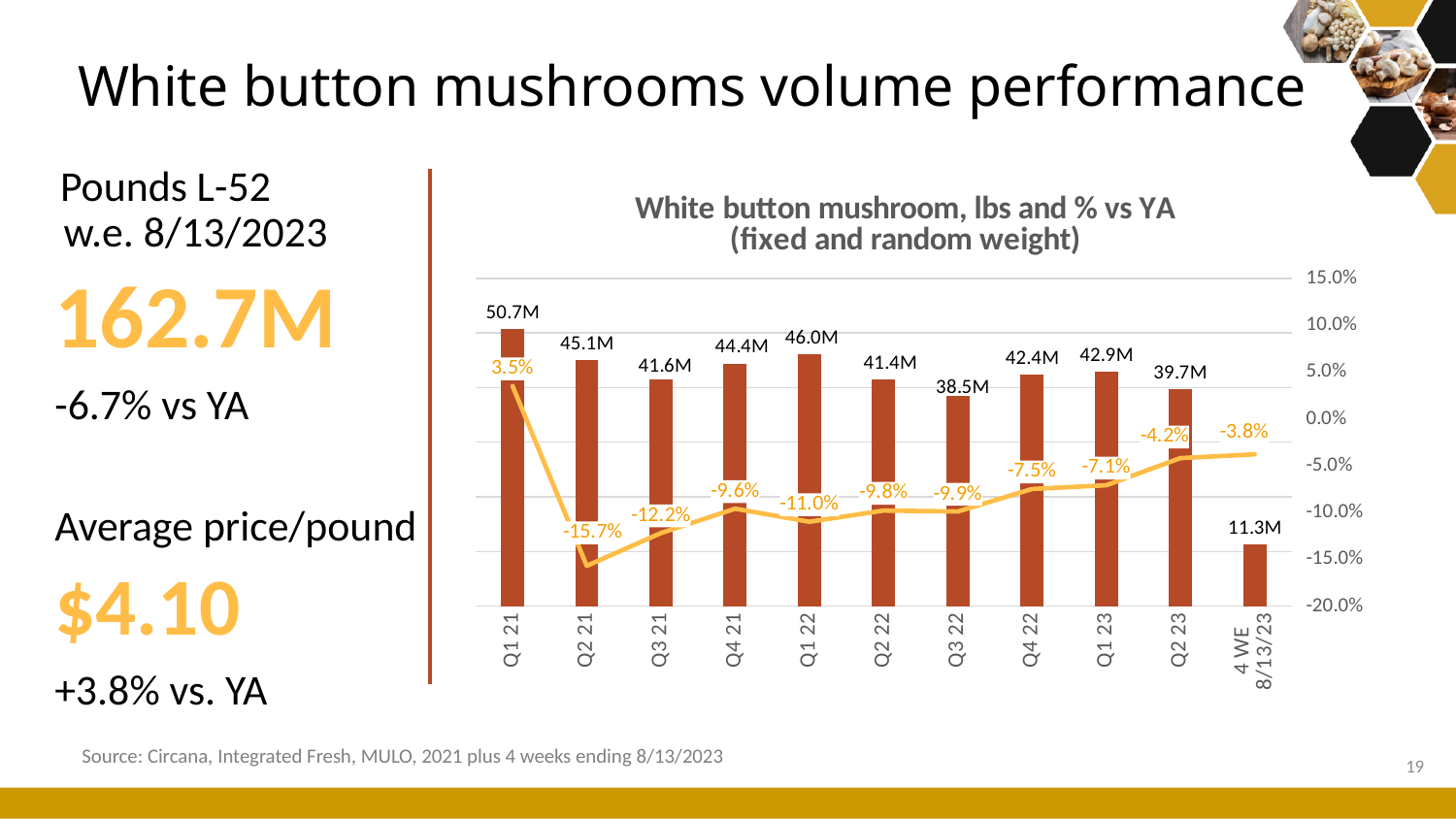
What is the % vs YA value for the 4 WE 8/13/23 period? -3.8% What is the title of the chart? White button mushroom, lbs and % vs YA (fixed and random weight) Which period has the highest volume in pounds? Q1 21 What is the volume in pounds for Q3 22? 38.5M From Q2 21 to Q2 23, does the % vs YA line generally rise or fall? Rise Which period has the lowest % vs YA value? Q2 21 What is the % vs YA value for Q2 21? -15.7% What is the difference in pounds between Q1 21 and Q2 21? 5.6M What is the volume in pounds for Q1 22? 46.0M How many periods are shown on the x axis? 11 Which has a higher volume in pounds, Q4 22 or Q1 23? Q1 23 What kind of chart is this? Combined bar and line chart